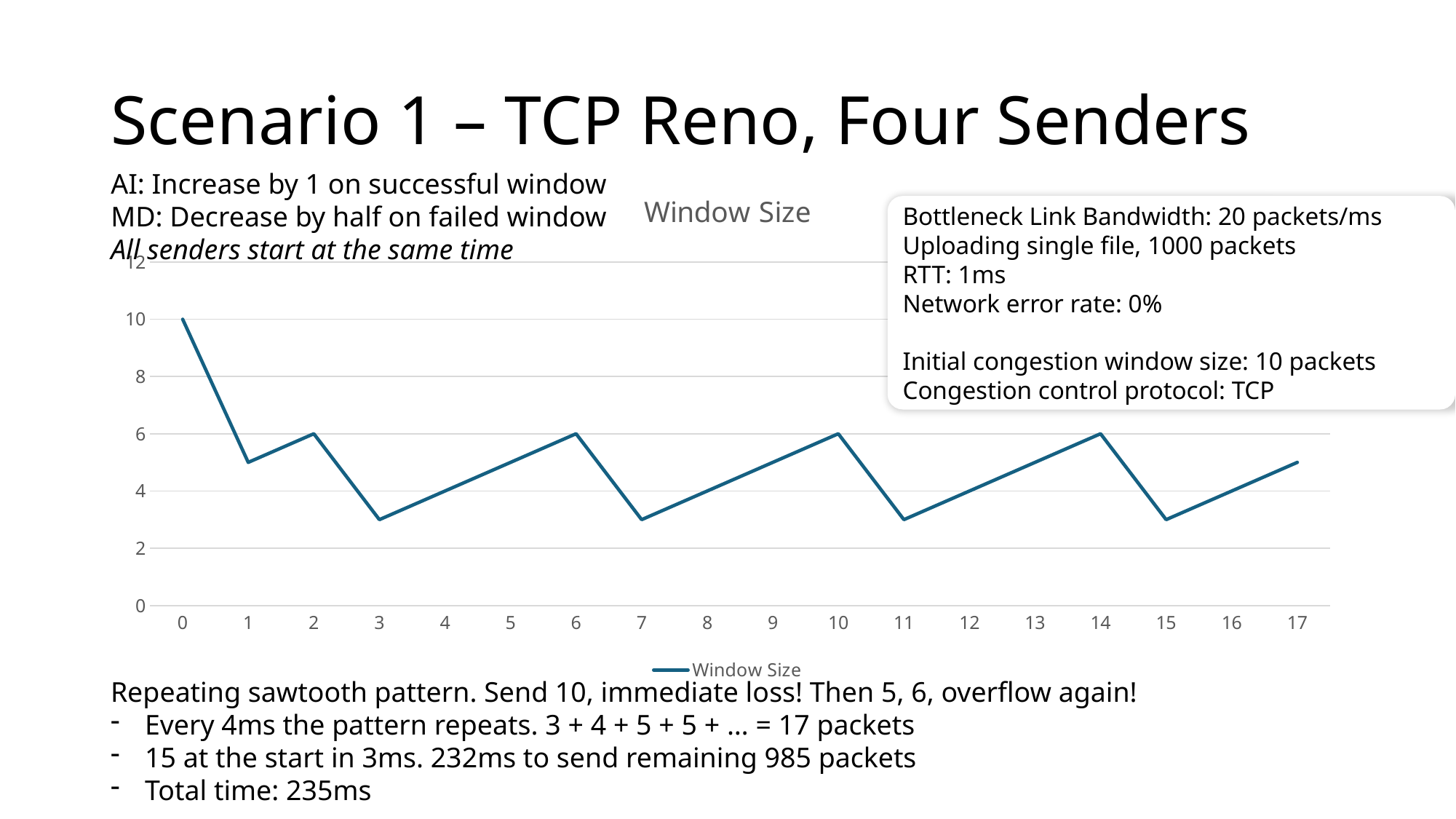
What is the window size at x = 2? 6 At which x value is the window size highest? 0 What kind of chart is shown on the slide? line chart How many data points are plotted along the x axis? 18 What is the title of the chart? Window Size Which is larger, the window size at x = 0 or at x = 14? x = 0 Does the window size rise or fall from x = 3 to x = 6? rise How many series does the legend list? 1 What is the difference between the window size at x = 0 and at x = 6? 4 What is the window size at x = 0? 10 Is the window size at x = 3 greater or less than 4? less What is the window size at x = 4? 4